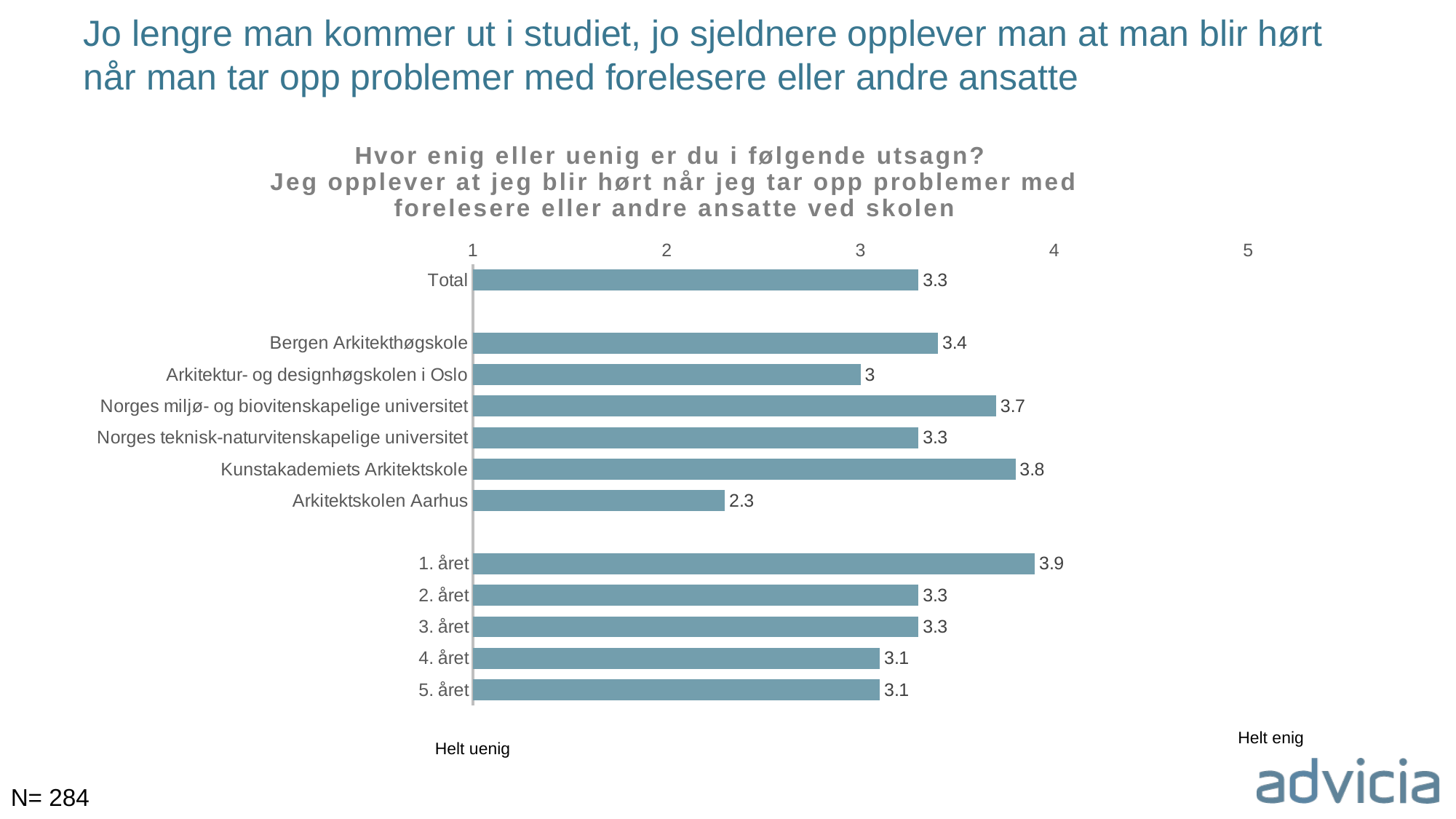
Do the values fall or rise from 1. året to 5. året? fall What kind of chart is shown on the slide? bar chart What is the value for Total? 3.3 What is the value for 1. året? 3.9 What is the value for Kunstakademiets Arkitektskole? 3.8 Which is larger, the value for Norges miljø- og biovitenskapelige universitet or the value for Arkitektur- og designhøgskolen i Oslo? Norges miljø- og biovitenskapelige universitet Is the value for Arkitektskolen Aarhus greater or less than 3? less Which category has the highest value? 1. året Which category has the lowest value? Arkitektskolen Aarhus How many bars are plotted in the chart? 12 What is the difference between the values for 1. året and 5. året? 0.8 What is the value for Arkitektskolen Aarhus? 2.3